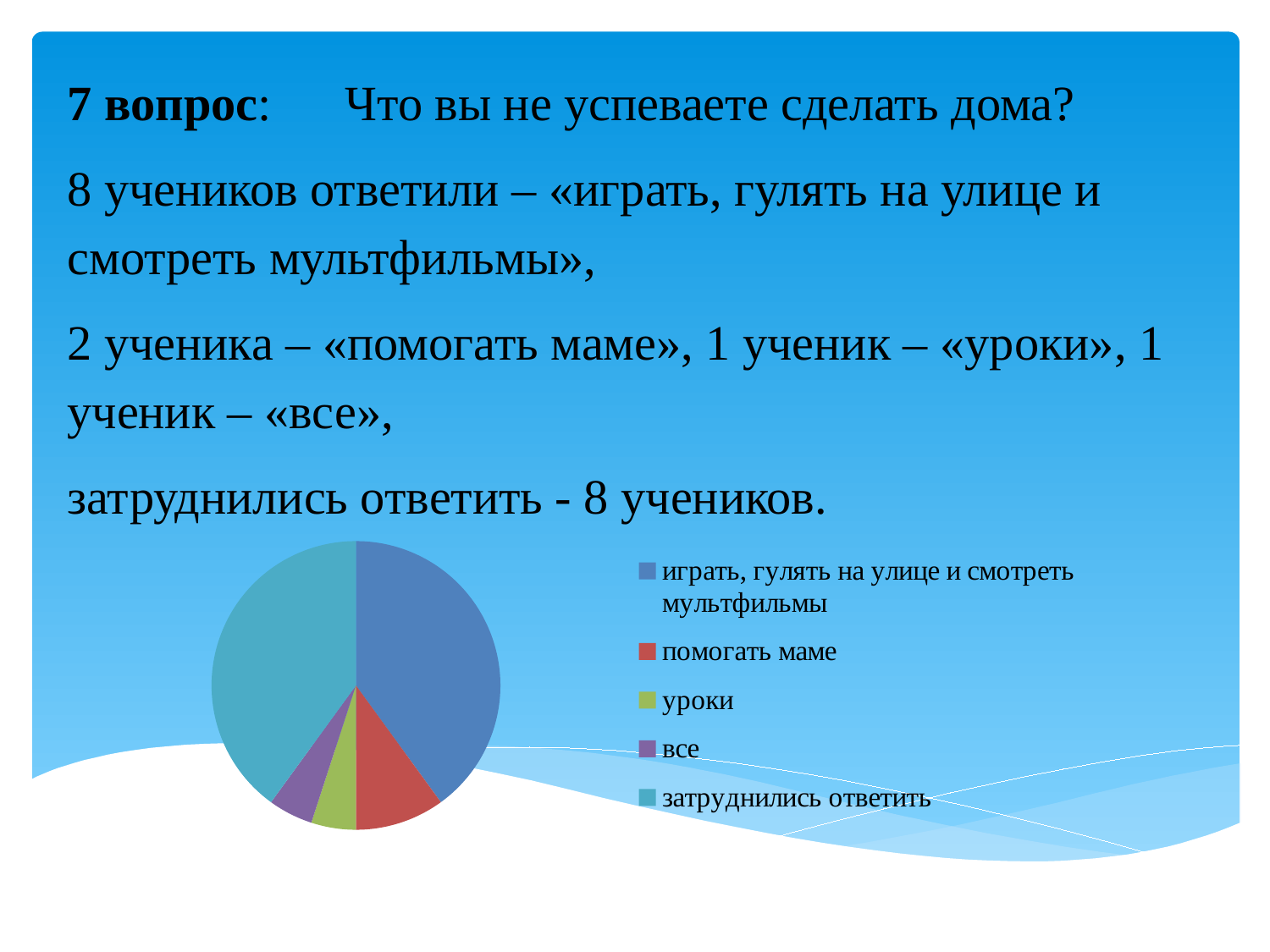
Which legend entry is shown in red in the pie chart? помогать маме What kind of chart is shown on the slide? pie chart How many entries does the legend of the pie chart list? 5 Which slice is larger: «помогать маме» or «все»? помогать маме How many slices does the pie chart have? 5 What colour is the slice for «затруднились ответить» in the pie chart? teal Which slice is larger: «затруднились ответить» or «уроки»? затруднились ответить Which slice is larger: «затруднились ответить» or «помогать маме»? затруднились ответить